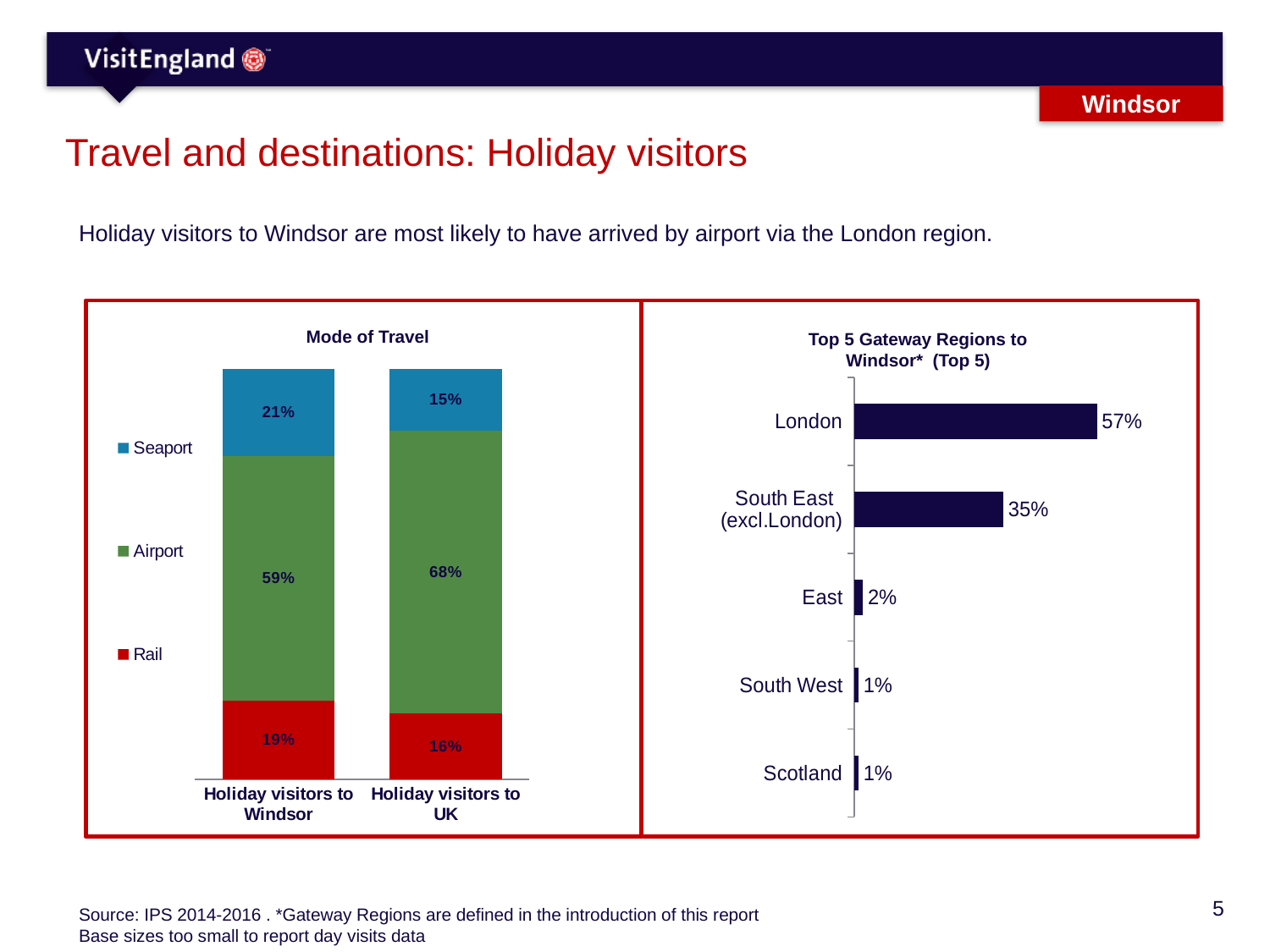
In the Mode of Travel chart, what is the total of the stacked bar for holiday visitors to Windsor? 99% In the Mode of Travel chart, how many series does the legend list? 3 In the Top 5 Gateway Regions to Windsor chart, how many regions are shown? 5 In the Mode of Travel chart, which colour represents Rail in the legend? Red In the Mode of Travel chart, what is the difference between the Seaport share for holiday visitors to Windsor and for holiday visitors to UK? 6% What kind of chart is the Mode of Travel chart? Stacked bar chart In the Mode of Travel chart, what percentage of holiday visitors to Windsor arrived by airport? 59% In the Top 5 Gateway Regions to Windsor chart, what is the difference between London and South East (excl.London)? 22% In the Top 5 Gateway Regions to Windsor chart, which region has the highest value? London In the Top 5 Gateway Regions to Windsor chart, what is the value for South East (excl.London)? 35% In the Mode of Travel chart, which is larger: the Airport share for holiday visitors to Windsor or for holiday visitors to UK? Holiday visitors to UK In the Mode of Travel chart, what percentage of holiday visitors to UK arrived by rail? 16%